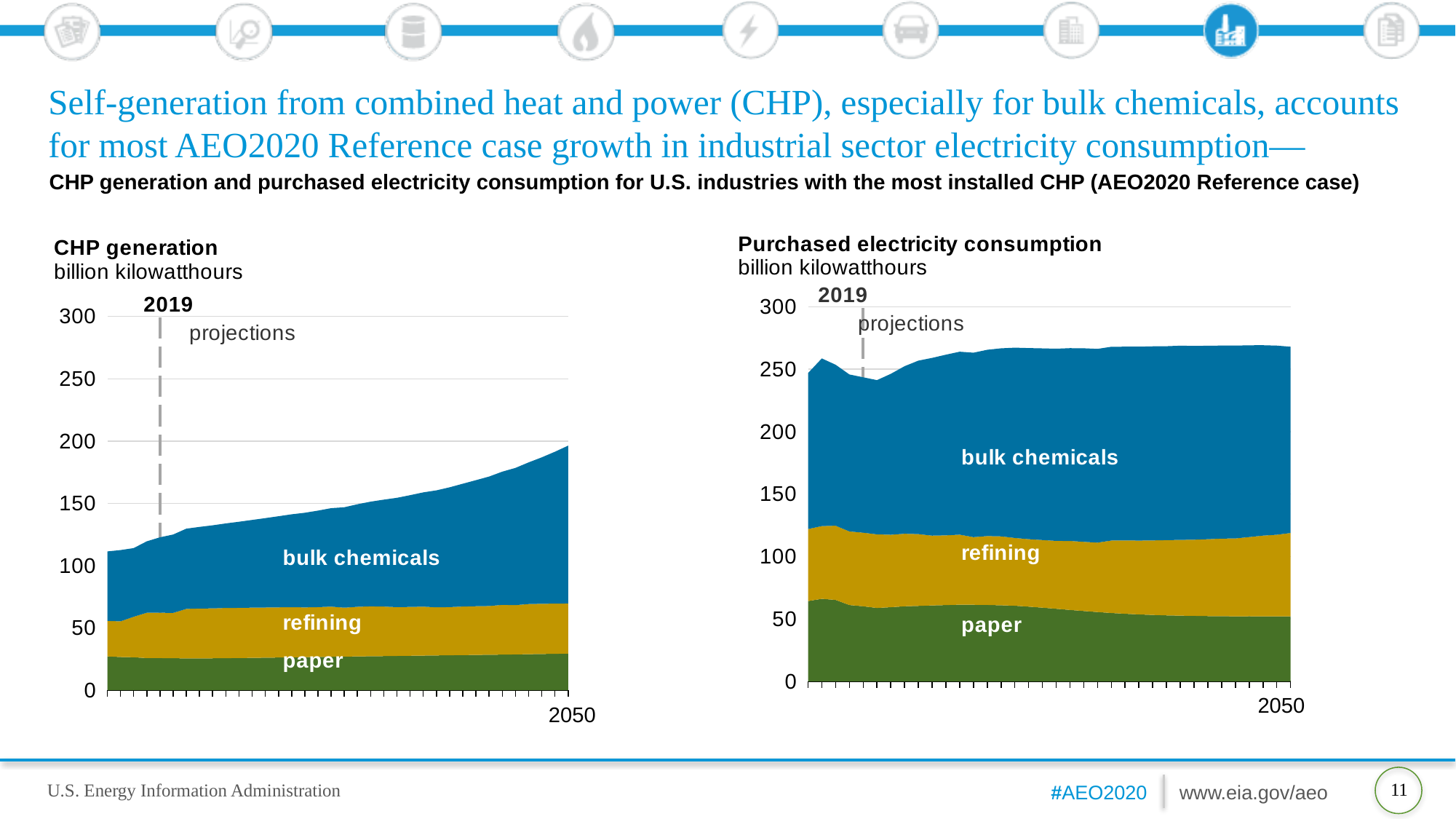
What kind of chart is the CHP generation chart on the left? stacked area chart In the CHP generation chart, is the total value in 2050 greater or less than 200? less In the CHP generation chart, which industry has the smallest CHP generation in 2050? paper How many industry series are shown in the Purchased electricity consumption chart? 3 In the CHP generation chart, is the total value in 2050 greater or less than 150? greater In the Purchased electricity consumption chart, is the total value in 2050 greater or less than 300? less What unit is used on the y axis of both charts? billion kilowatthours Which three industries are shown in the CHP generation chart? bulk chemicals, refining, paper In the Purchased electricity consumption chart, which industry accounts for the largest share of consumption in 2050? bulk chemicals In the CHP generation chart, does total CHP generation rise or fall from the start of the series to 2050? rise In the Purchased electricity consumption chart, does the paper industry's consumption rise or fall from the start of the series to 2050? fall